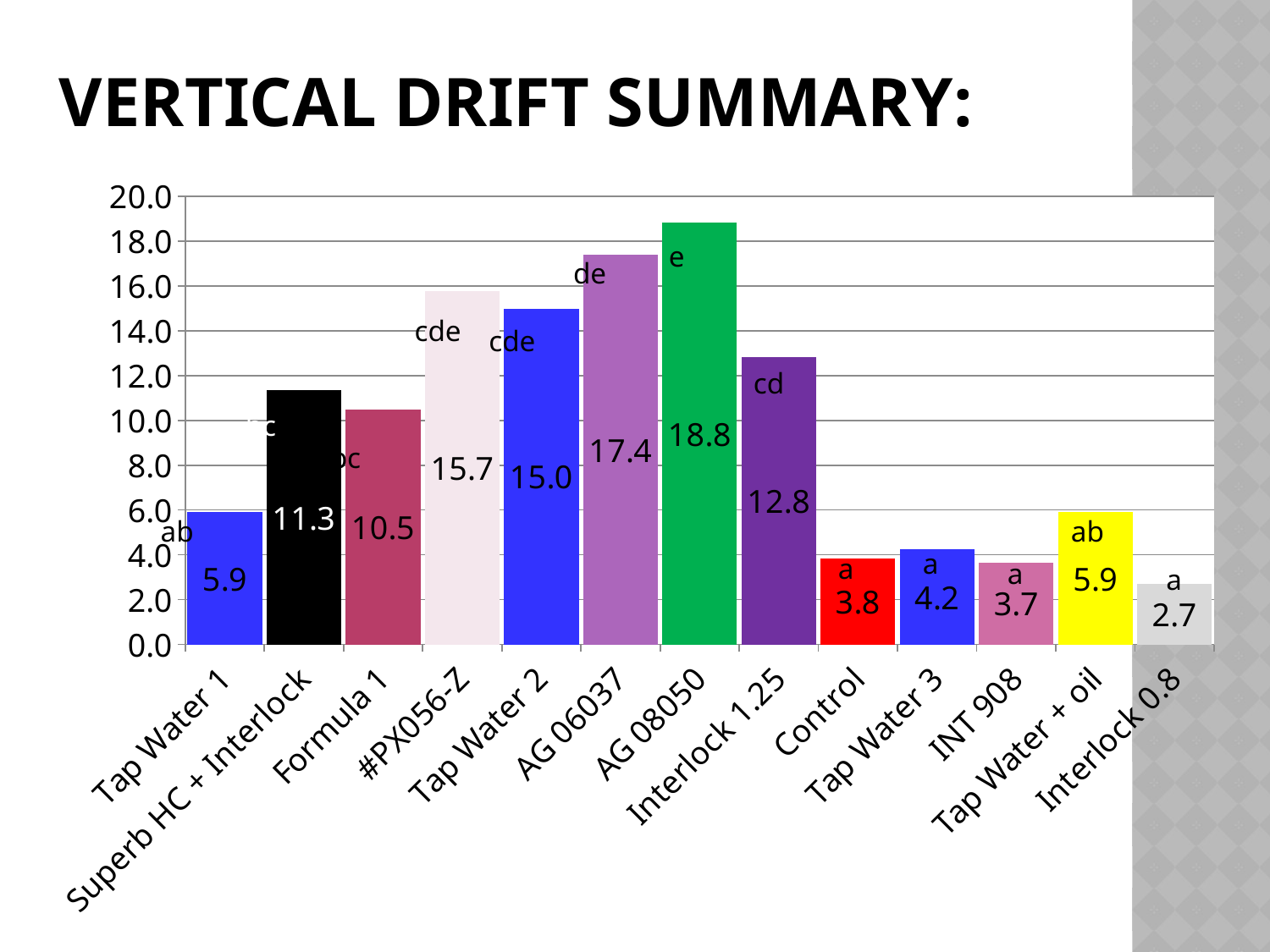
What is the title of the slide? VERTICAL DRIFT SUMMARY: How many categories are shown on the x axis? 13 Which is larger, the value for Superb HC + Interlock or the value for Formula 1? Superb HC + Interlock Which category has the highest value? AG 08050 What is the value for Interlock 1.25? 12.8 What is the difference between the values for Tap Water 3 and INT 908? 0.5 What is the difference between the values for AG 06037 and Tap Water 2? 2.4 What kind of chart is shown on the slide? bar chart Is the value for #PX056-Z greater or less than 14.0? greater What is the value for Control? 3.8 What is the value for AG 08050? 18.8 Which category has the lowest value? Interlock 0.8